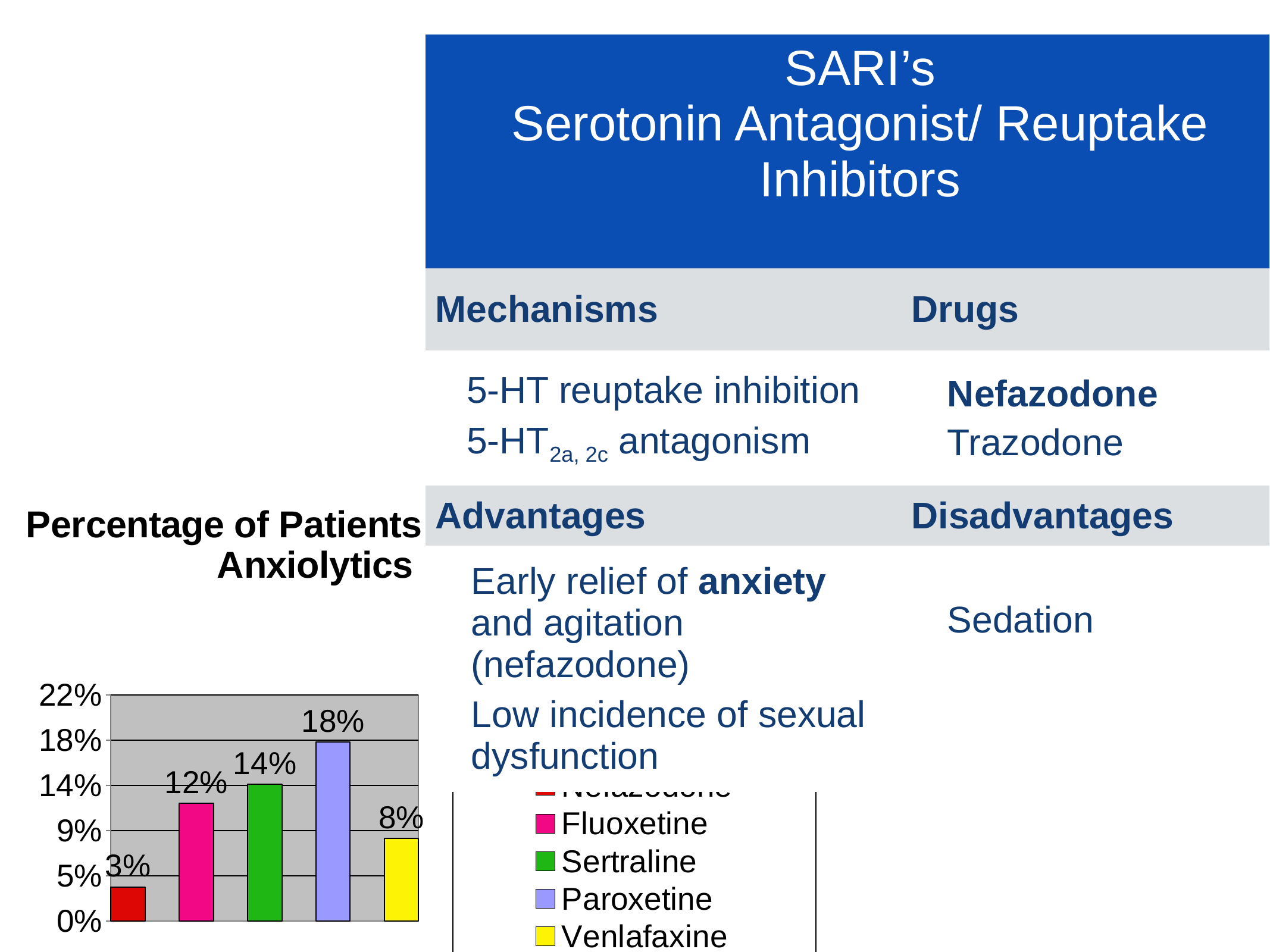
What is the value for Paroxetine in the bar chart? 18% What is the difference between the values for Paroxetine and Fluoxetine? 6% What is the value for Venlafaxine in the bar chart? 8% What is the value for Fluoxetine in the bar chart? 12% What kind of chart is shown on the slide? Bar chart Which drug has the highest percentage of patients in the bar chart? Paroxetine What colour is the bar for Venlafaxine? Yellow Which is larger, the value for Sertraline or the value for Venlafaxine? Sertraline What is the value for Sertraline in the bar chart? 14% What is the lowest value shown on any bar in the chart? 3% How many bars are plotted in the chart? 5 What is the difference between the values for Sertraline and Venlafaxine? 6%